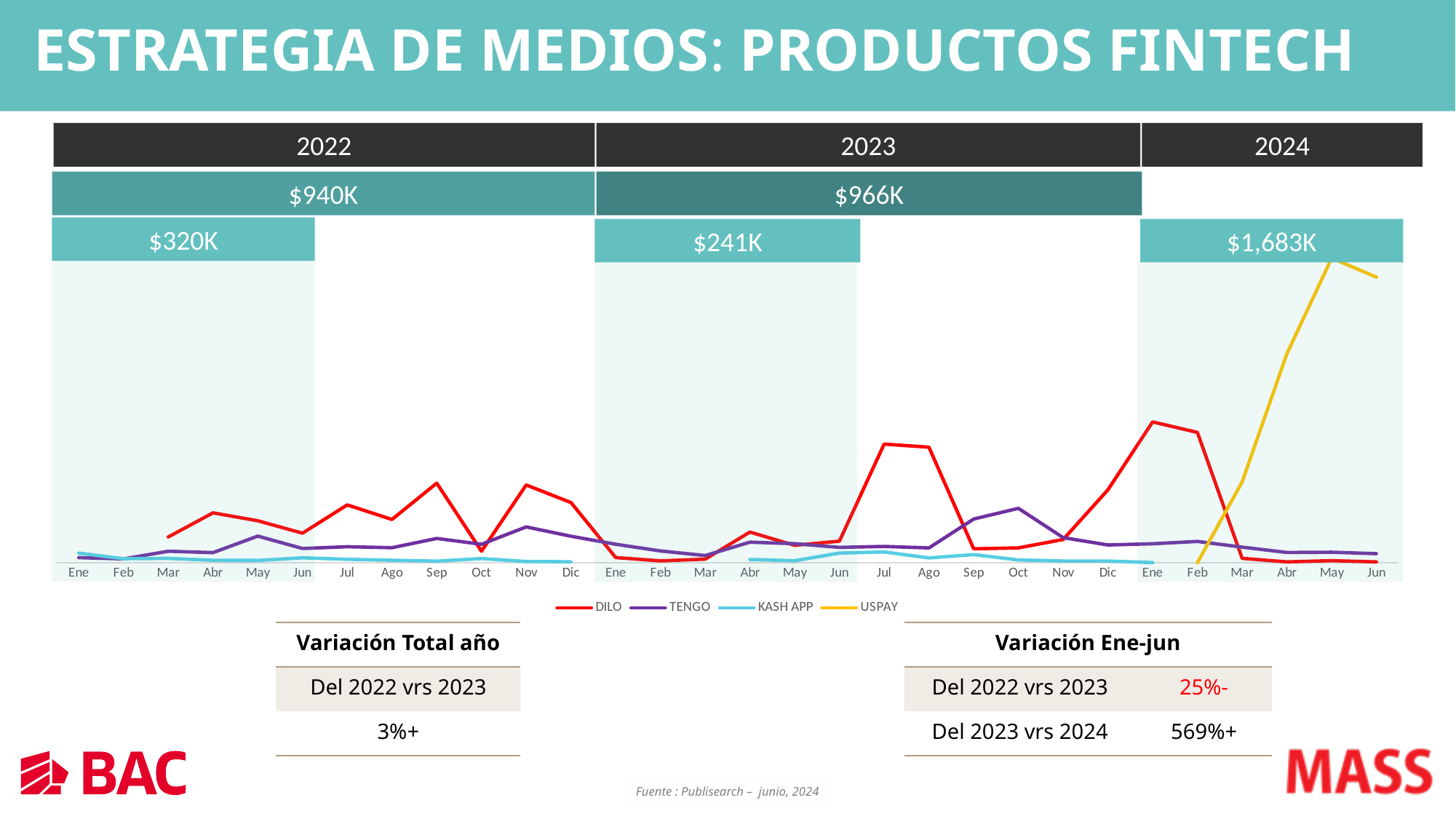
What total value is shown for 2022 above the chart? $940K Which series are listed in the chart legend? DILO, TENGO, KASH APP, USPAY What colour is the DILO line in the chart? red What total value is shown for 2023 above the chart? $966K What value is shown for the Ene-Jun period of 2024? $1,683K What kind of chart is shown on the slide? line chart Which series reaches the highest point on the chart in 2024? USPAY Does the USPAY line rise or fall from Feb to May 2024? rises How many months are plotted for 2024 on the x axis? 6 How many series does the chart legend list? 4 What is the difference between the 2023 total ($966K) and the 2022 total ($940K)? $26K Which Ene-Jun value is larger, 2022 ($320K) or 2023 ($241K)? 2022